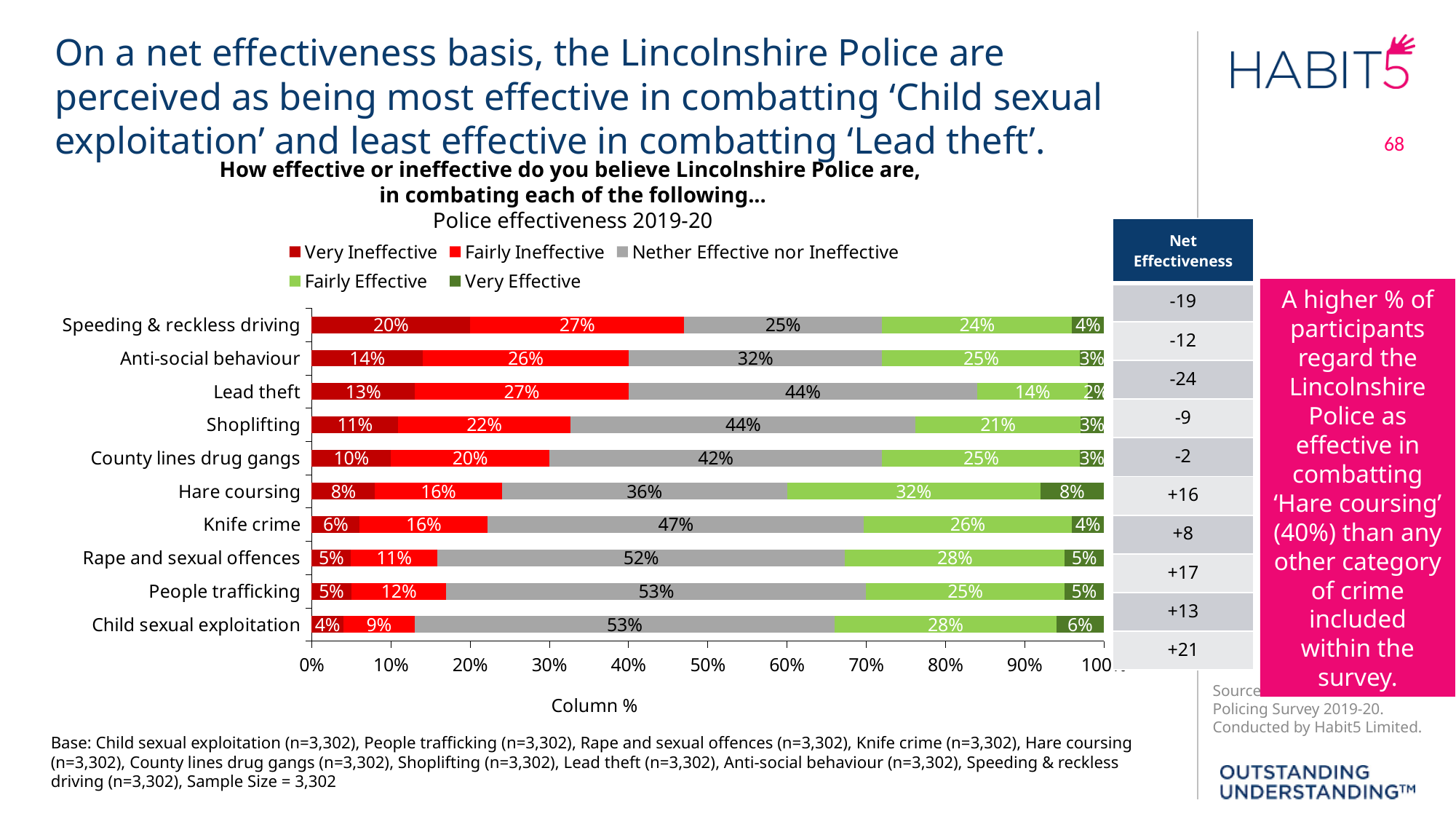
What percentage of respondents rated Lincolnshire Police as 'Very Ineffective' at combating Speeding & reckless driving? 20% Which has a larger 'Very Effective' value, Hare coursing or Knife crime? Hare coursing How many series does the legend list? 5 Which category has the lowest 'Fairly Effective' value? Lead theft What is the 'Fairly Effective' value for Hare coursing? 32% What kind of chart is shown on the slide? Stacked bar chart What is the 'Nether Effective nor Ineffective' value for Lead theft? 44% What is the 'Very Effective' value for Child sexual exploitation? 6% What is the combined 'Fairly Effective' and 'Very Effective' total for Hare coursing? 40% How many crime categories are shown on the chart? 10 Which category has the highest 'Very Ineffective' value? Speeding & reckless driving What is the difference between the 'Fairly Ineffective' values for Speeding & reckless driving and Child sexual exploitation? 18%